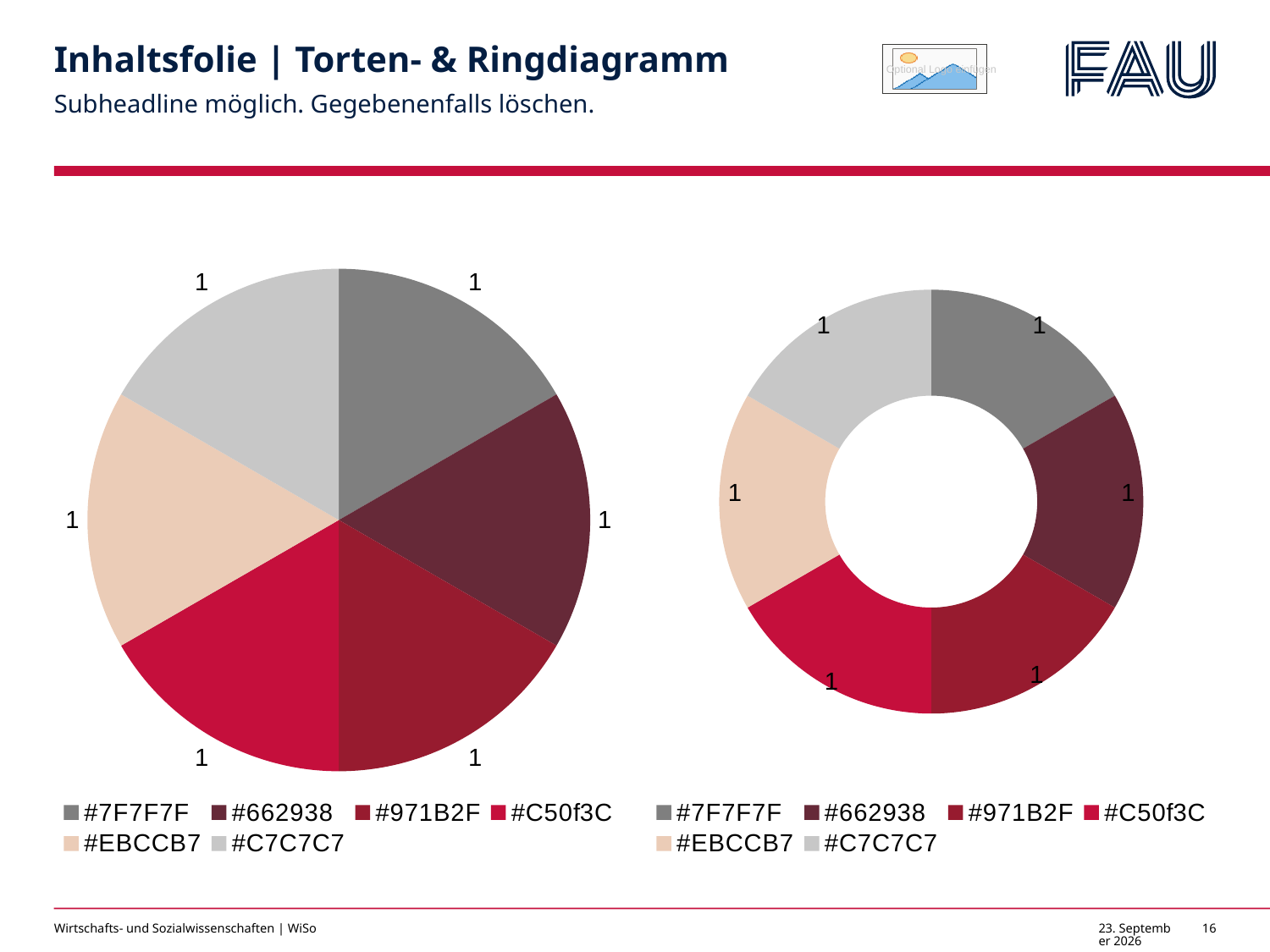
In the pie chart on the left, what is the total of all slice values? 6 In the pie chart on the left, how many slices are there? 6 In the doughnut chart on the right, how many segments are there? 6 In the doughnut chart on the right, which legend entry corresponds to the darkest red segment? #662938 In the pie chart on the left, what is the difference between the values of the #662938 and #C7C7C7 slices? 0 What kind of chart is the chart on the right of the slide? doughnut chart In the pie chart on the left, what is the value of the #7F7F7F slice? 1 In the pie chart on the left, what share of the whole pie does the #971B2F slice represent? 1/6 In the doughnut chart on the right, what share of the whole ring does the #C50f3C segment represent? 1/6 How many entries does the legend of the pie chart on the left list? 6 What kind of chart is the chart on the left of the slide? pie chart In the doughnut chart on the right, what is the value of the #EBCCB7 segment? 1